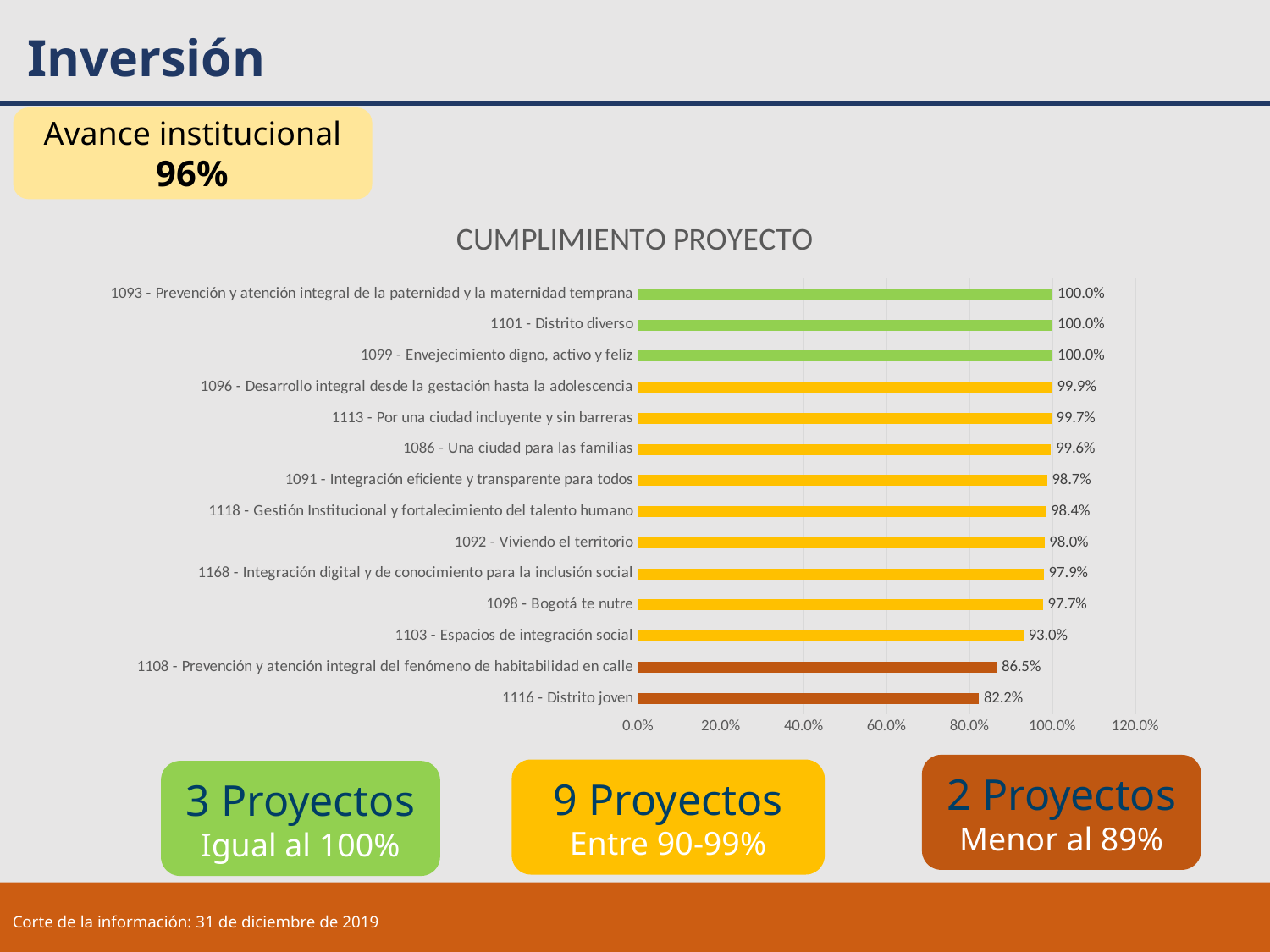
What is the difference between the values for 1103 - Espacios de integración social and 1116 - Distrito joven? 10.8% What is the value for 1108 - Prevención y atención integral del fenómeno de habitabilidad en calle? 86.5% Is the value for 1108 - Prevención y atención integral del fenómeno de habitabilidad en calle greater or less than 80.0%? greater What is the title of the chart? CUMPLIMIENTO PROYECTO What is the value for 1098 - Bogotá te nutre? 97.7% What is the value for 1116 - Distrito joven? 82.2% Which category has the lowest value? 1116 - Distrito joven How many categories have a value of 100.0%? 3 What is the value for 1103 - Espacios de integración social? 93.0% Which is larger, the value for 1092 - Viviendo el territorio or the value for 1103 - Espacios de integración social? 1092 - Viviendo el territorio How many categories are shown in the chart? 14 What kind of chart is shown? bar chart